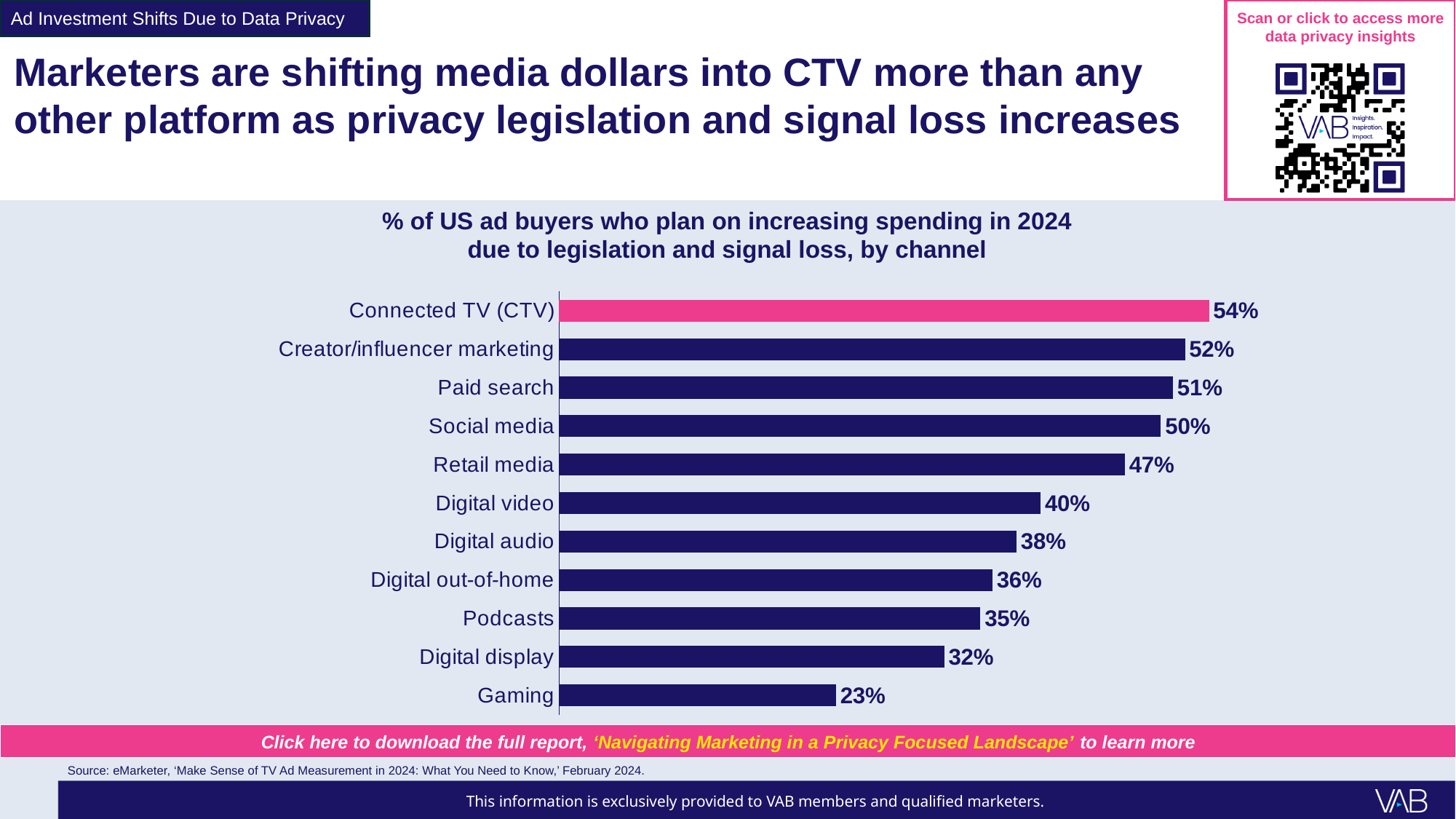
What is the difference in percentage points between Connected TV (CTV) and Gaming? 31 Which channel has the highest percentage of ad buyers planning to increase spending? Connected TV (CTV) Which has a higher value, Paid search or Digital out-of-home? Paid search Which has a higher value, Digital video or Digital audio? Digital video What type of chart is shown on the slide? Bar chart What is the value shown for Podcasts? 35% How many channels are shown in the chart? 11 Which bar is highlighted in pink rather than dark blue? Connected TV (CTV) What is the difference in percentage points between Social media and Digital display? 18 What percentage of US ad buyers plan on increasing spending on Connected TV (CTV)? 54% Which channel has the lowest percentage of ad buyers planning to increase spending? Gaming What is the value shown for Retail media? 47%